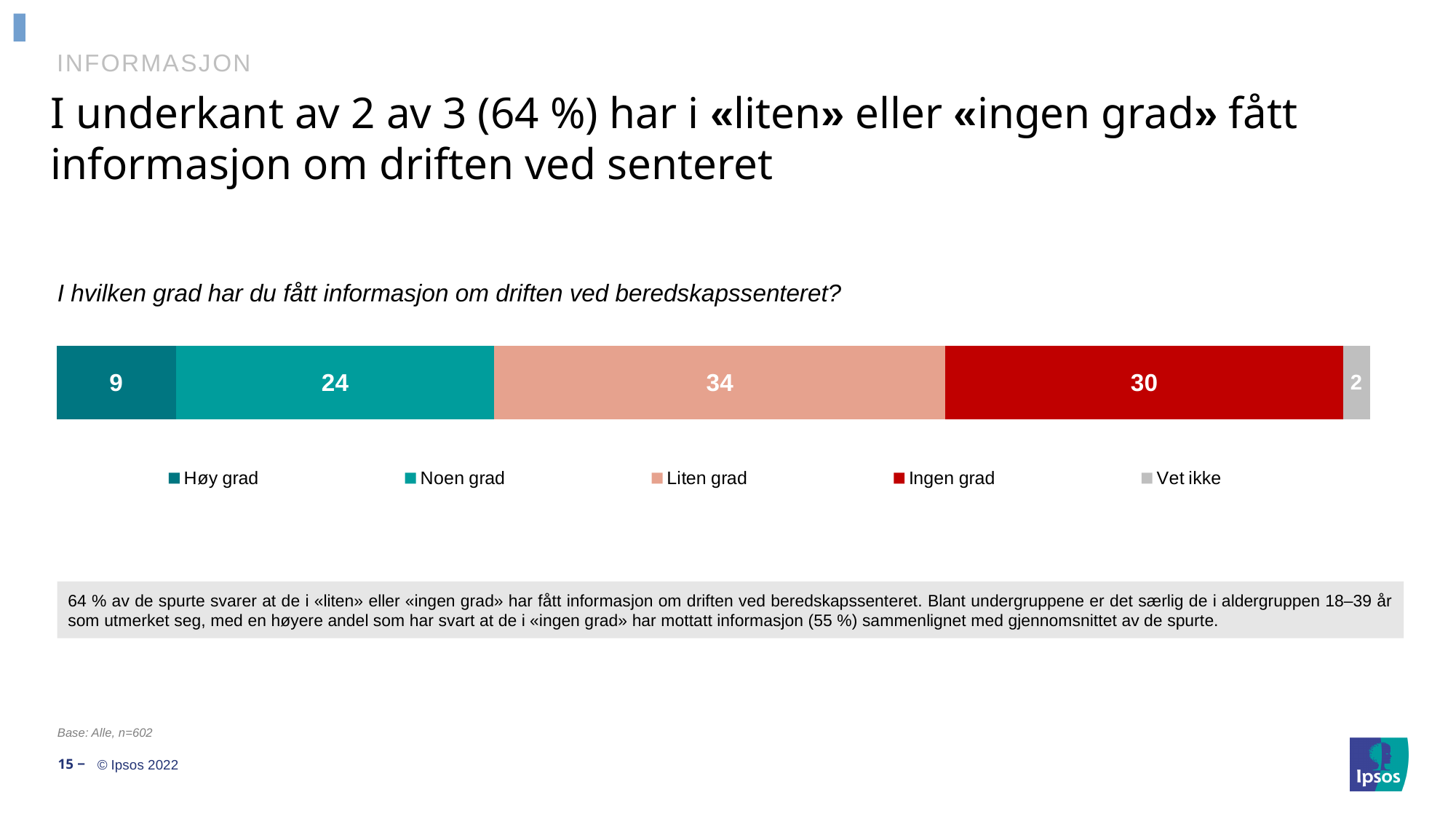
What colour is the "Ingen grad" segment in the chart? Red Which is larger, the value for "Noen grad" or the value for "Ingen grad"? Ingen grad Which response category has the lowest value? Vet ikke What is the difference between the values for "Liten grad" and "Ingen grad"? 4 How many series does the legend list? 5 What is the value for "Vet ikke" in the stacked bar? 2 What kind of chart is shown on the slide? Stacked bar chart Which response category has the highest value? Liten grad What is the value for "Høy grad" in the stacked bar? 9 What is the total of all segments in the stacked bar? 99 What is the combined value of "Liten grad" and "Ingen grad"? 64 What is the value for "Liten grad" in the stacked bar? 34